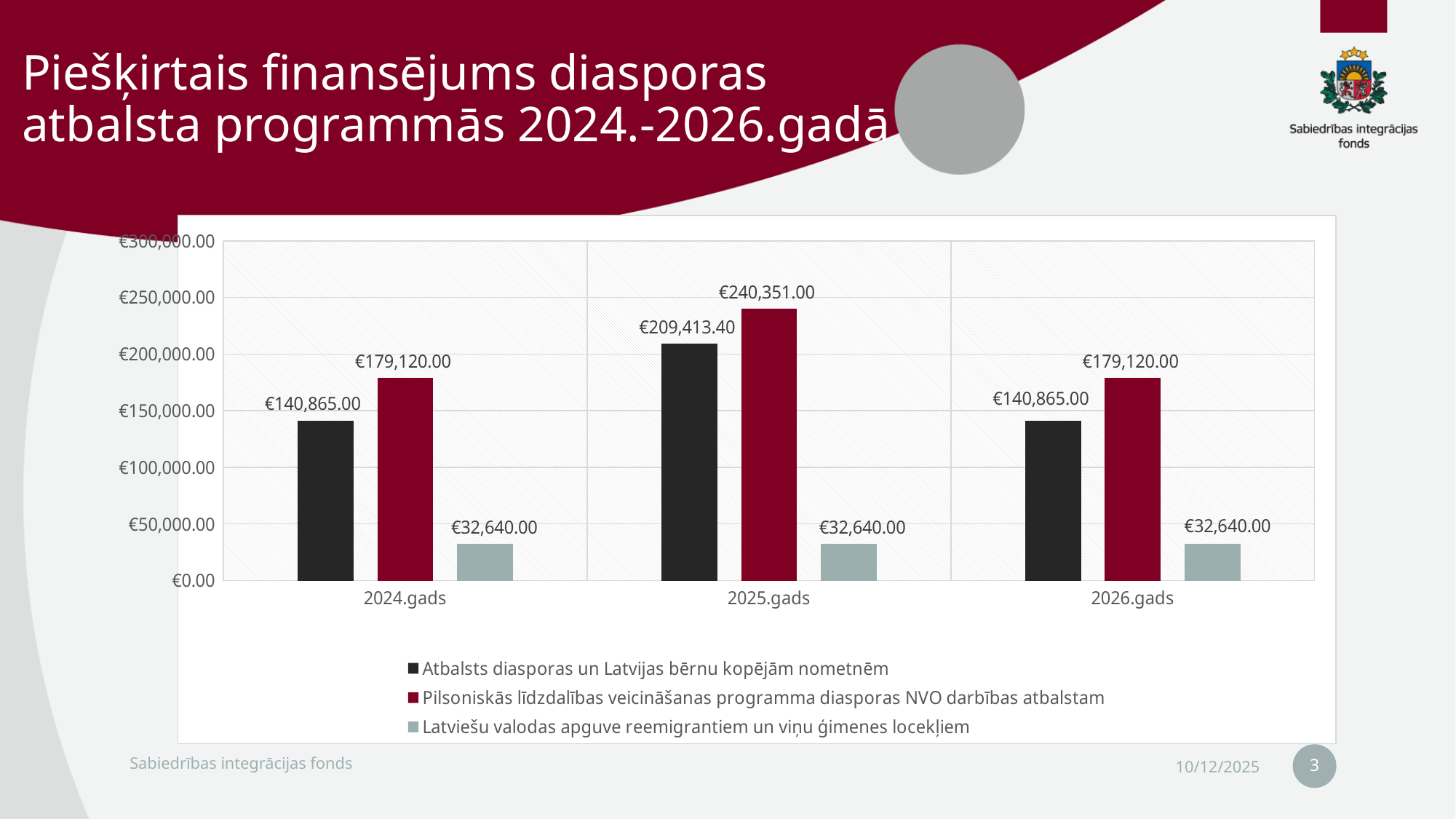
What is the difference between the 'Pilsoniskās līdzdalības veicināšanas programma diasporas NVO darbības atbalstam' value and the 'Atbalsts diasporas un Latvijas bērnu kopējām nometnēm' value in 2025.gads? €30,937.60 What is the value for 'Pilsoniskās līdzdalības veicināšanas programma diasporas NVO darbības atbalstam' in 2025.gads? €240,351.00 How many series does the legend list? 3 What colour are the bars for 'Latviešu valodas apguve reemigrantiem un viņu ģimenes locekļiem'? grey What type of chart is shown on the slide? bar chart What is the value for 'Atbalsts diasporas un Latvijas bērnu kopējām nometnēm' in 2025.gads? €209,413.40 How many year categories are shown on the x axis? 3 Which is larger in 2024.gads: 'Atbalsts diasporas un Latvijas bērnu kopējām nometnēm' or 'Pilsoniskās līdzdalības veicināšanas programma diasporas NVO darbības atbalstam'? Pilsoniskās līdzdalības veicināšanas programma diasporas NVO darbības atbalstam What is the value for 'Latviešu valodas apguve reemigrantiem un viņu ģimenes locekļiem' in 2024.gads? €32,640.00 In which year is the value for 'Pilsoniskās līdzdalības veicināšanas programma diasporas NVO darbības atbalstam' highest? 2025.gads What is the value for 'Atbalsts diasporas un Latvijas bērnu kopējām nometnēm' in 2026.gads? €140,865.00 Which series has the lowest value in 2026.gads? Latviešu valodas apguve reemigrantiem un viņu ģimenes locekļiem